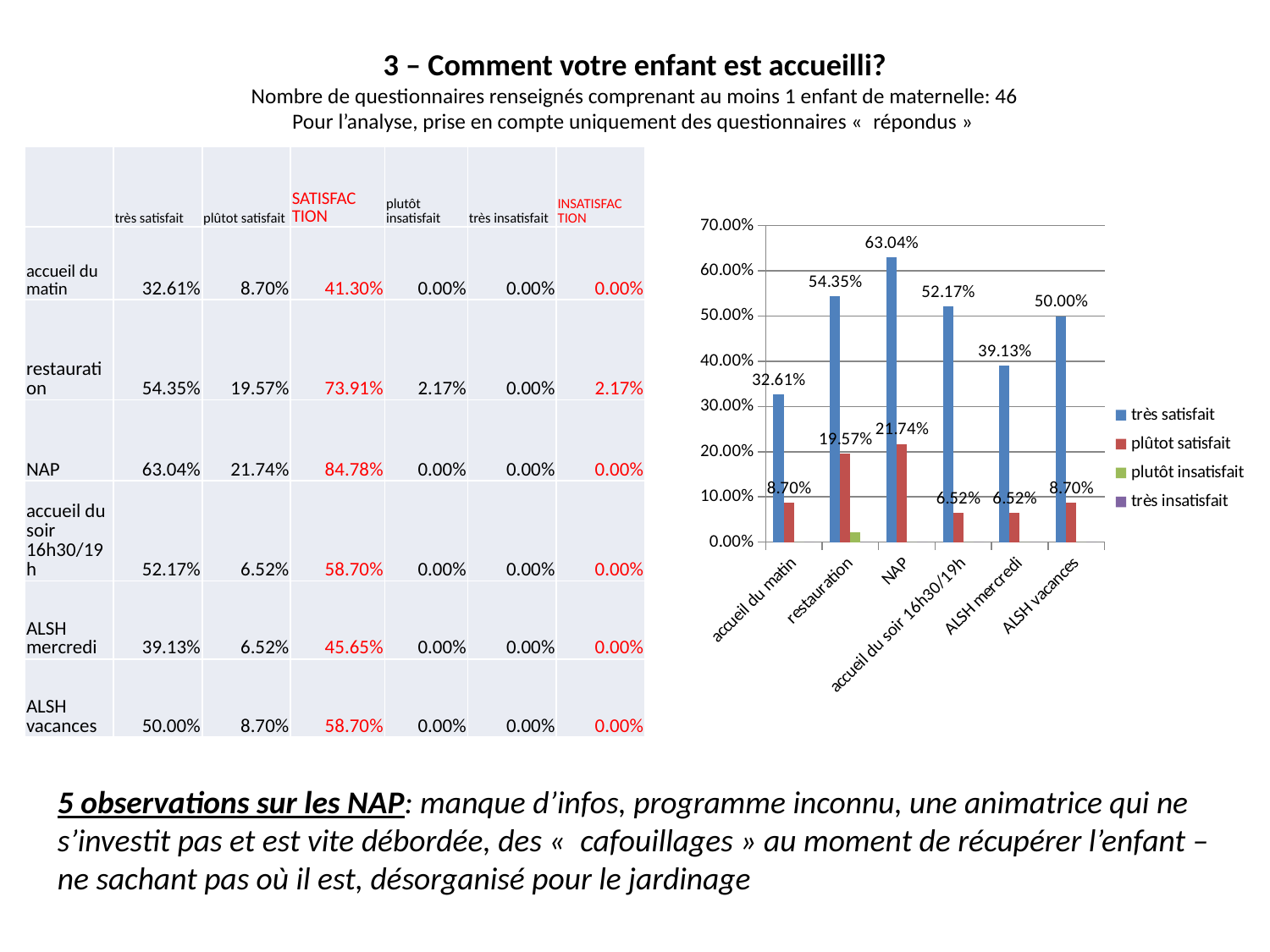
What is the value of the "plûtot satisfait" series for restauration? 19.57% Which category has the lowest "très satisfait" value? accueil du matin What is the difference between the "très satisfait" values for NAP and accueil du matin? 30.43% What is the value of the "très satisfait" series for NAP? 63.04% How many categories are shown on the x axis of the chart? 6 What kind of chart is shown on the slide? bar chart Which has a larger "très satisfait" value, restauration or accueil du soir 16h30/19h? restauration How many series does the chart legend list? 4 What is the value of the "très satisfait" series for ALSH vacances? 50.00% Which category has the highest "très satisfait" value? NAP Is the "plutôt insatisfait" value for restauration greater or less than 10.00%? less Which category has the highest "plûtot satisfait" value? NAP